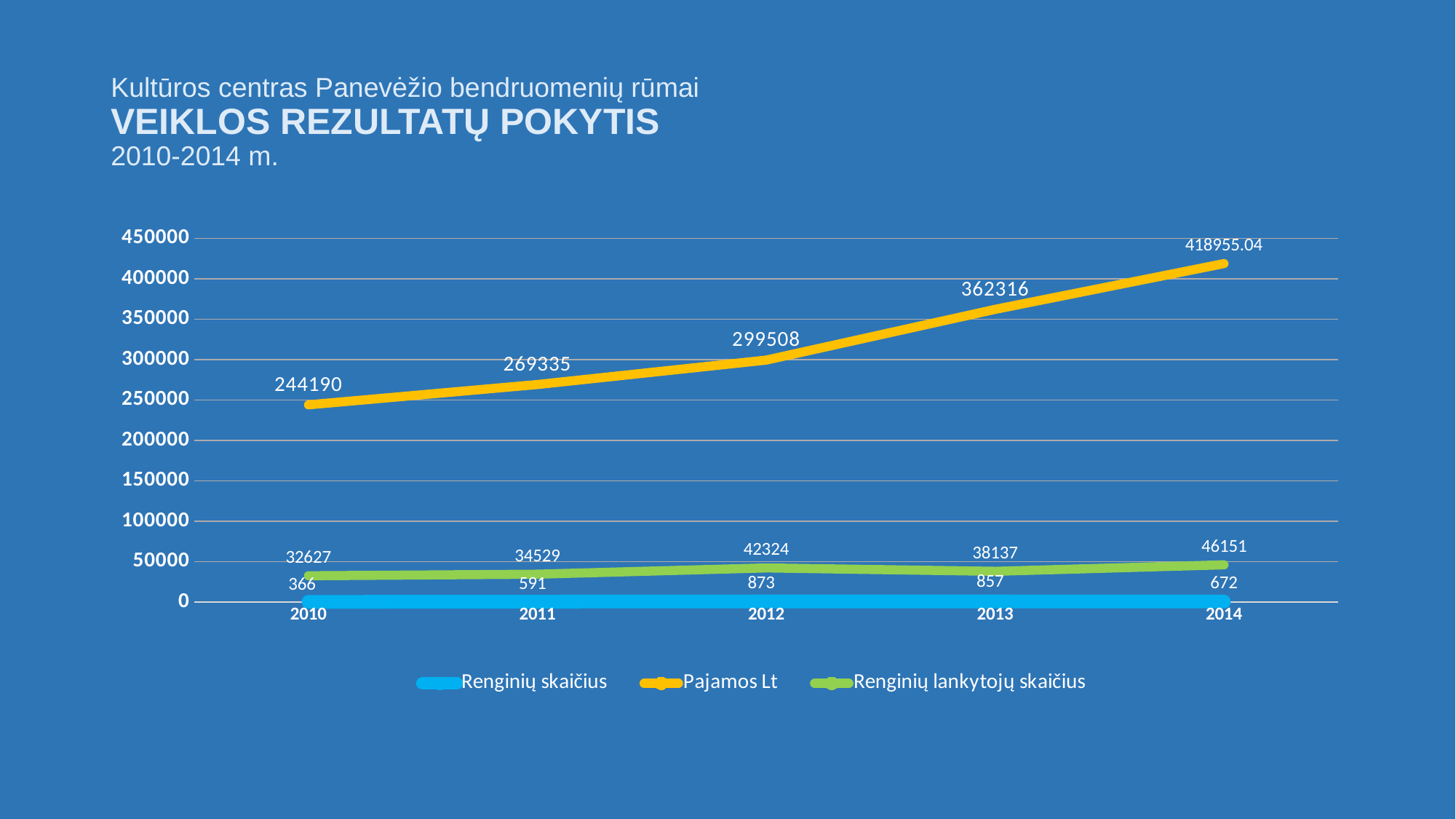
What colour is the line for Pajamos Lt? yellow How many years are plotted along the x axis? 5 What kind of chart is shown on the slide? line chart What is the value of Renginių skaičius in 2011? 591 How many series does the legend list? 3 What is the difference between Pajamos Lt in 2013 and in 2012? 62808 What is the value of Pajamos Lt in 2012? 299508 In which year is Pajamos Lt highest? 2014 Which is larger: Renginių lankytojų skaičius in 2012 or in 2013? 2012 What is the value of Renginių lankytojų skaičius in 2013? 38137 In which year is Renginių skaičius lowest? 2010 Does Pajamos Lt rise or fall from 2010 to 2014? rise